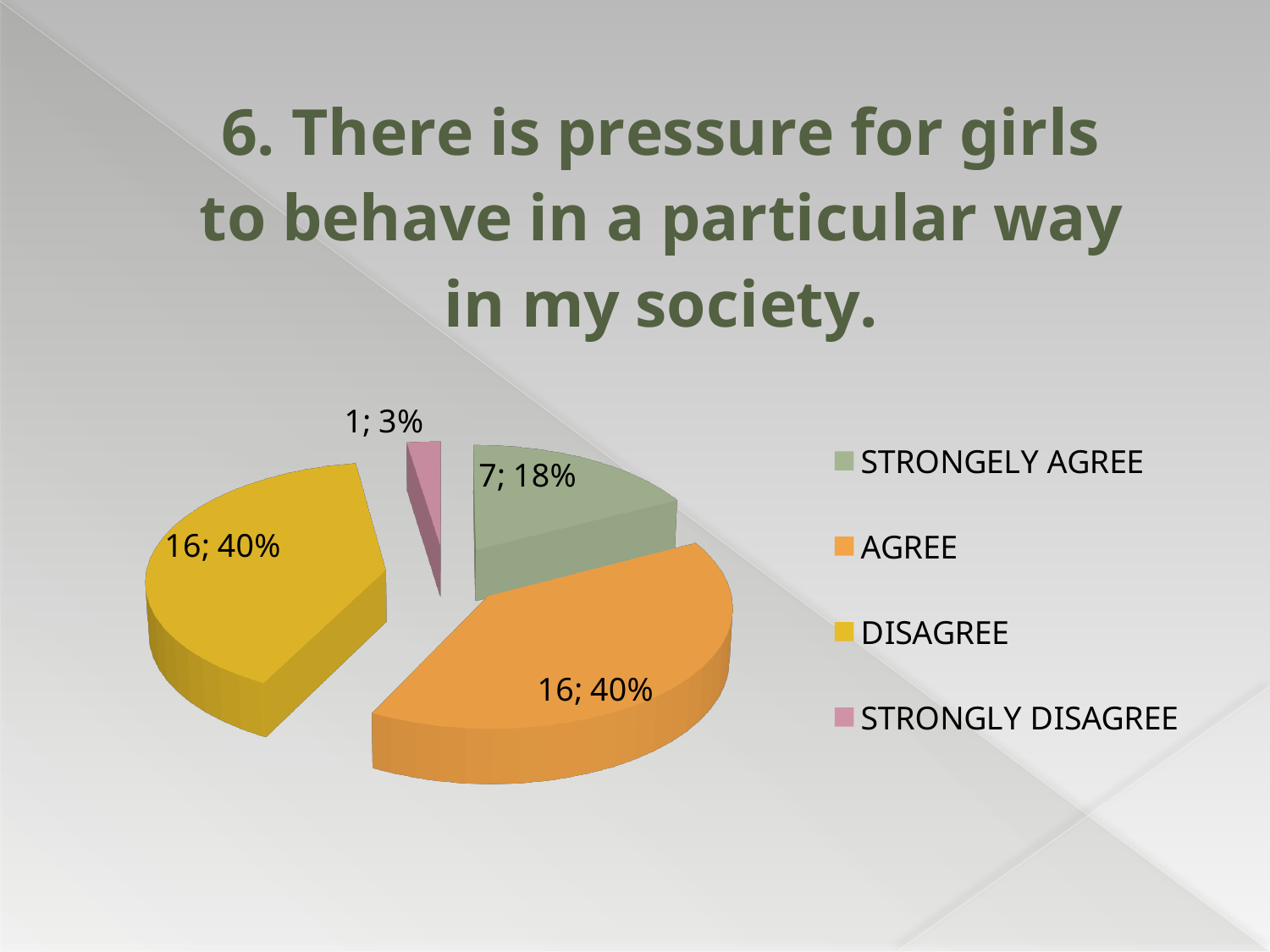
What colour is the AGREE slice in the pie chart? orange What share of the pie does the DISAGREE slice represent? 40% Which is larger, the STRONGLY AGREE slice or the STRONGLY DISAGREE slice? STRONGLY AGREE What is the difference between the number of STRONGLY AGREE responses and STRONGLY DISAGREE responses? 6 How many respondents chose AGREE? 16 How many respondents chose STRONGLY DISAGREE? 1 How many respondents chose STRONGLY AGREE? 7 What is the total number of responses across all slices of the pie? 40 How many categories does the pie chart have? 4 What kind of chart is shown on the slide? pie chart Which category has the smallest slice of the pie? STRONGLY DISAGREE What percentage of the pie is the STRONGLY AGREE slice? 18%